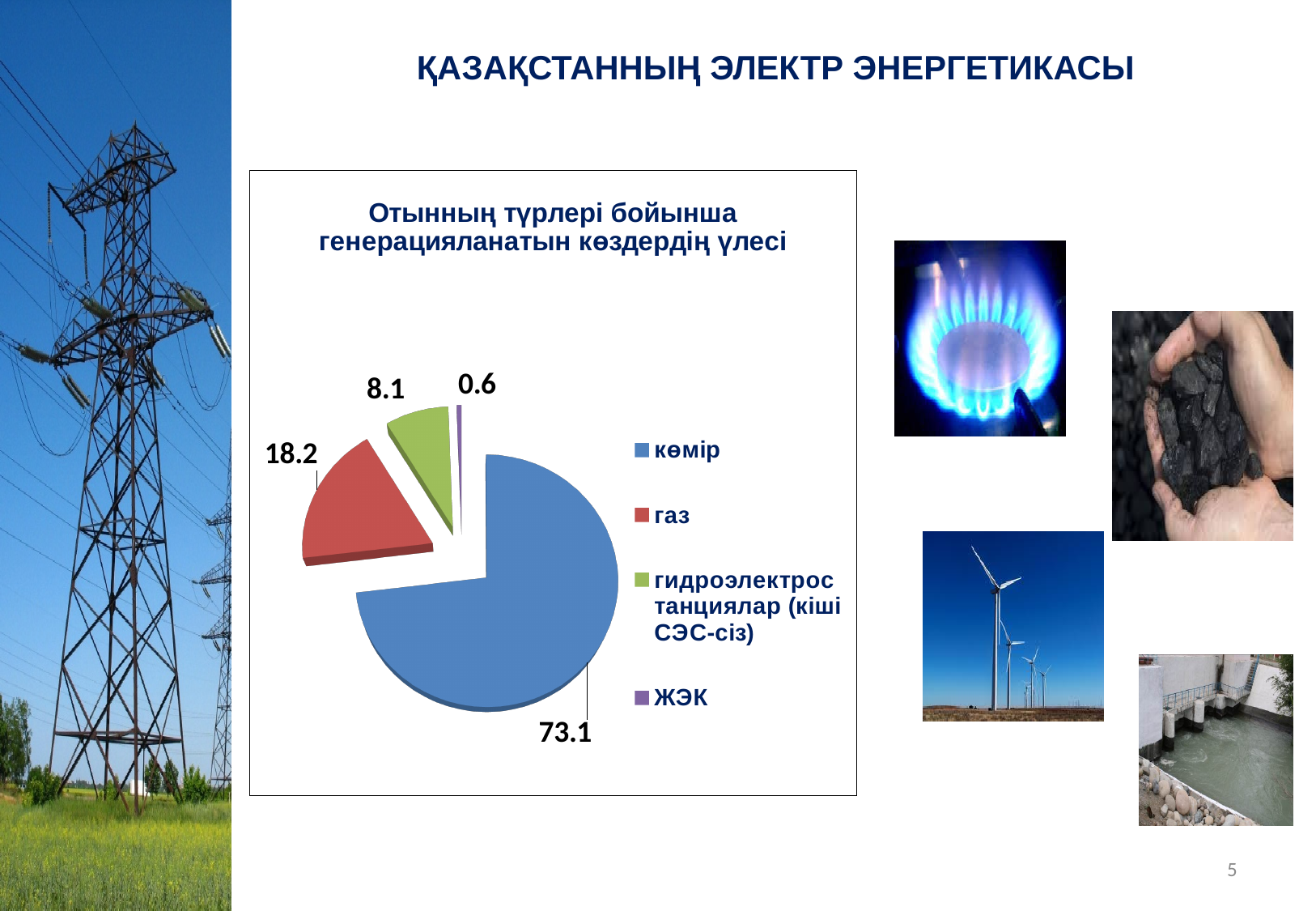
What type of chart is shown on the slide? pie chart Which category has the largest slice in the pie chart? көмір What colour is the slice for газ in the pie chart? red What is the value for гидроэлектростанциялар (кіші СЭС-сіз) in the pie chart? 8.1 Which category has the smallest slice in the pie chart? ЖЭК What is the value for көмір in the pie chart? 73.1 Which is larger, the value for газ or the value for гидроэлектростанциялар (кіші СЭС-сіз)? газ What is the title of the pie chart? Отынның түрлері бойынша генерацияланатын көздердің үлесі What is the value for газ in the pie chart? 18.2 What is the value for ЖЭК in the pie chart? 0.6 What is the difference between the values for көмір and газ? 54.9 How many categories does the pie chart show? 4